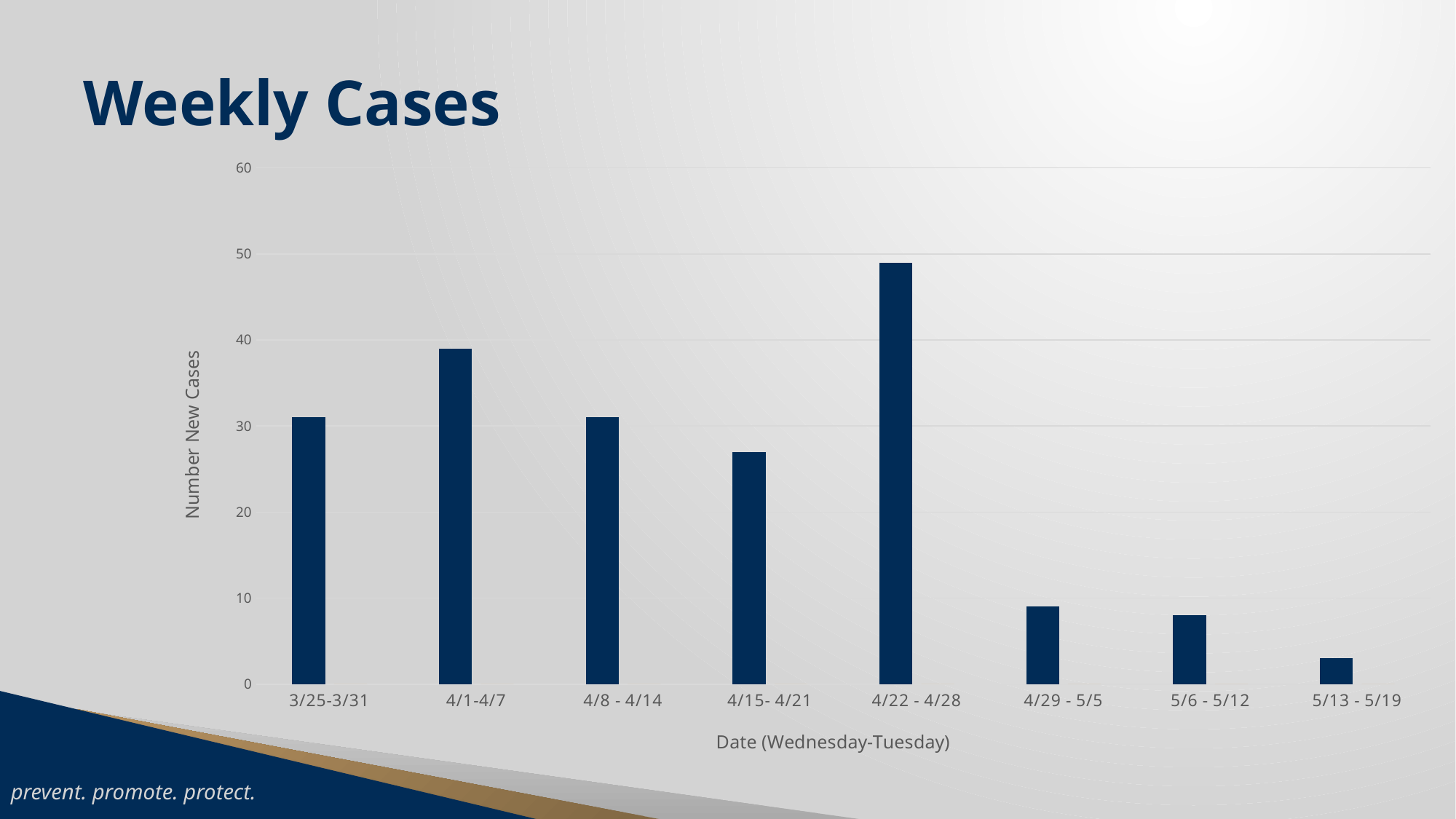
What kind of chart is shown on the slide? bar chart Which week has the highest number of new cases? 4/22 - 4/28 How many weekly date ranges are plotted on the chart? 8 Is the value for 4/1-4/7 greater or less than 30? greater Which week has more new cases, 4/15- 4/21 or 4/29 - 5/5? 4/15- 4/21 What is the label on the vertical axis of the chart? Number New Cases Do the values rise or fall from 4/22 - 4/28 through 5/13 - 5/19? fall Is the value for 4/22 - 4/28 greater or less than 40? greater Is the value for 5/13 - 5/19 greater or less than 10? less Which week has more new cases, 4/1-4/7 or 4/22 - 4/28? 4/22 - 4/28 Which week has the lowest number of new cases? 5/13 - 5/19